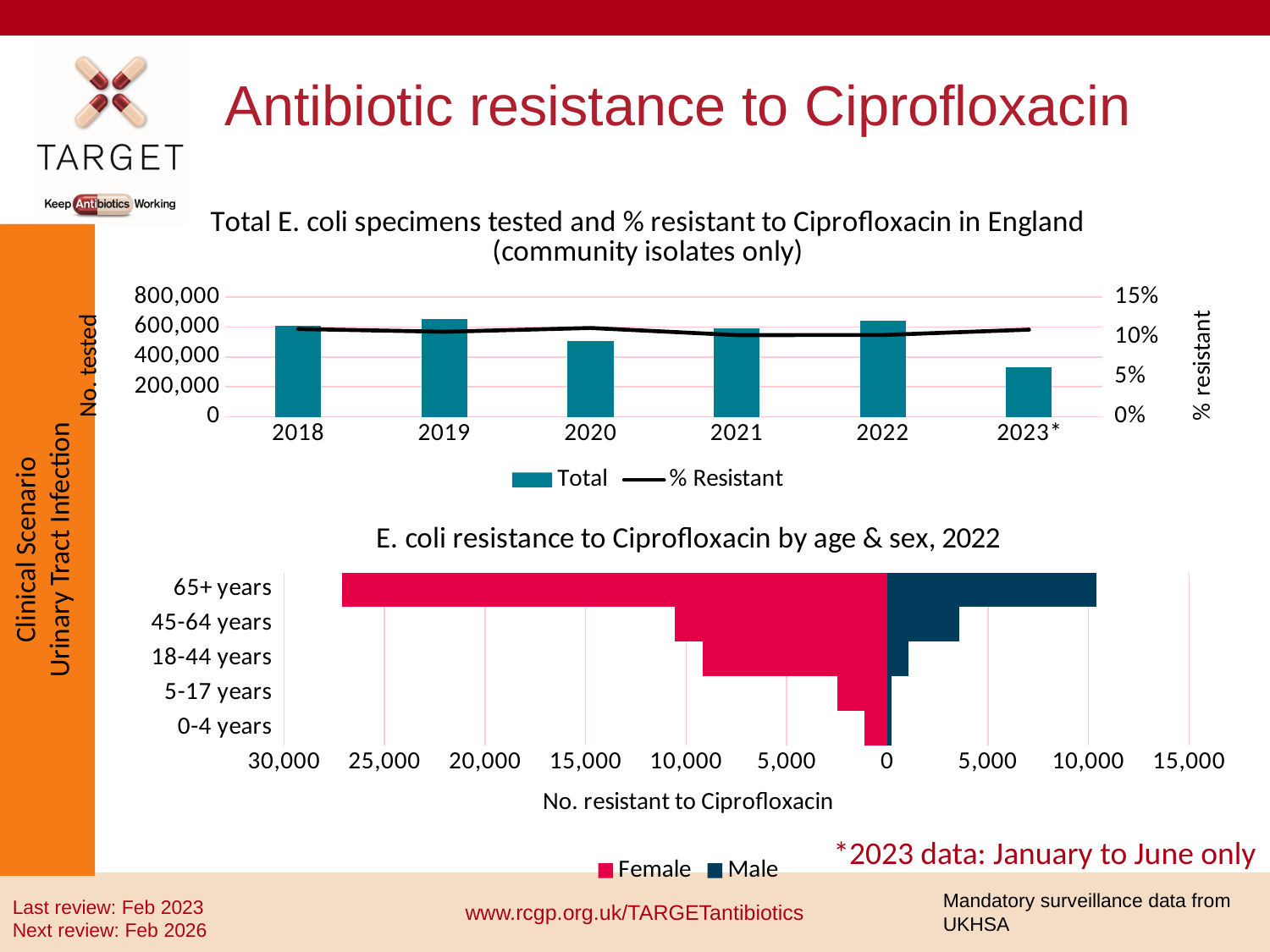
In the top chart, how many years are shown on the x axis? 6 In the top chart, is the % resistant in 2018 greater or less than 5%? greater In the bottom chart, which age group has the highest number of resistant Female isolates? 65+ years In the bottom chart, is the Male value for 45-64 years greater or less than 5,000? less In the top chart, is the number tested in 2023* greater or less than 400,000? less In the top chart, how many series does the legend list? 2 In the bottom chart, 'E. coli resistance to Ciprofloxacin by age & sex, 2022', how many age groups are shown? 5 In the top chart, which year has the lowest number tested? 2023* What kind of chart is the top chart, 'Total E. coli specimens tested and % resistant to Ciprofloxacin in England'? Bar chart with a line In the top chart, which year has the larger number tested, 2020 or 2021? 2021